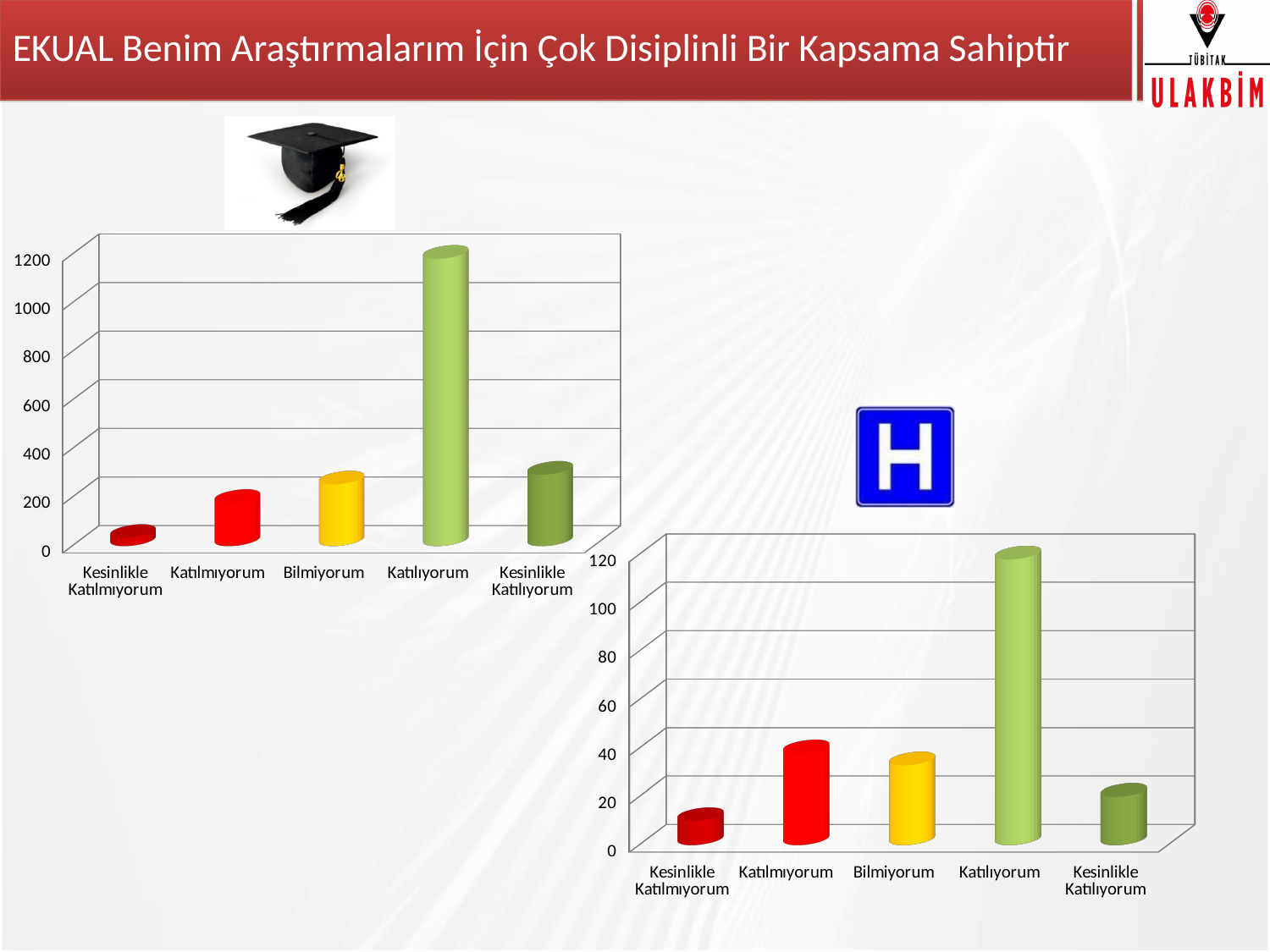
In the right chart (with the hospital sign), is the value for Kesinlikle Katılıyorum greater or less than 40? less In the left chart (with the graduation cap), is the value for Bilmiyorum greater or less than 600? less In the right chart (with the hospital sign), which is larger, the value for Katılıyorum or the value for Bilmiyorum? Katılıyorum In the right chart (with the hospital sign), which category has the lowest value? Kesinlikle Katılmıyorum In the right chart (with the hospital sign), is the value for Katılıyorum greater or less than 100? greater In the right chart (with the hospital sign), which category has the highest value? Katılıyorum In the left chart (with the graduation cap), which category has the highest value? Katılıyorum In the left chart (with the graduation cap), which category has the lowest value? Kesinlikle Katılmıyorum How many categories are shown in the left chart (with the graduation cap)? 5 What kind of chart is the right chart (with the hospital sign)? bar chart